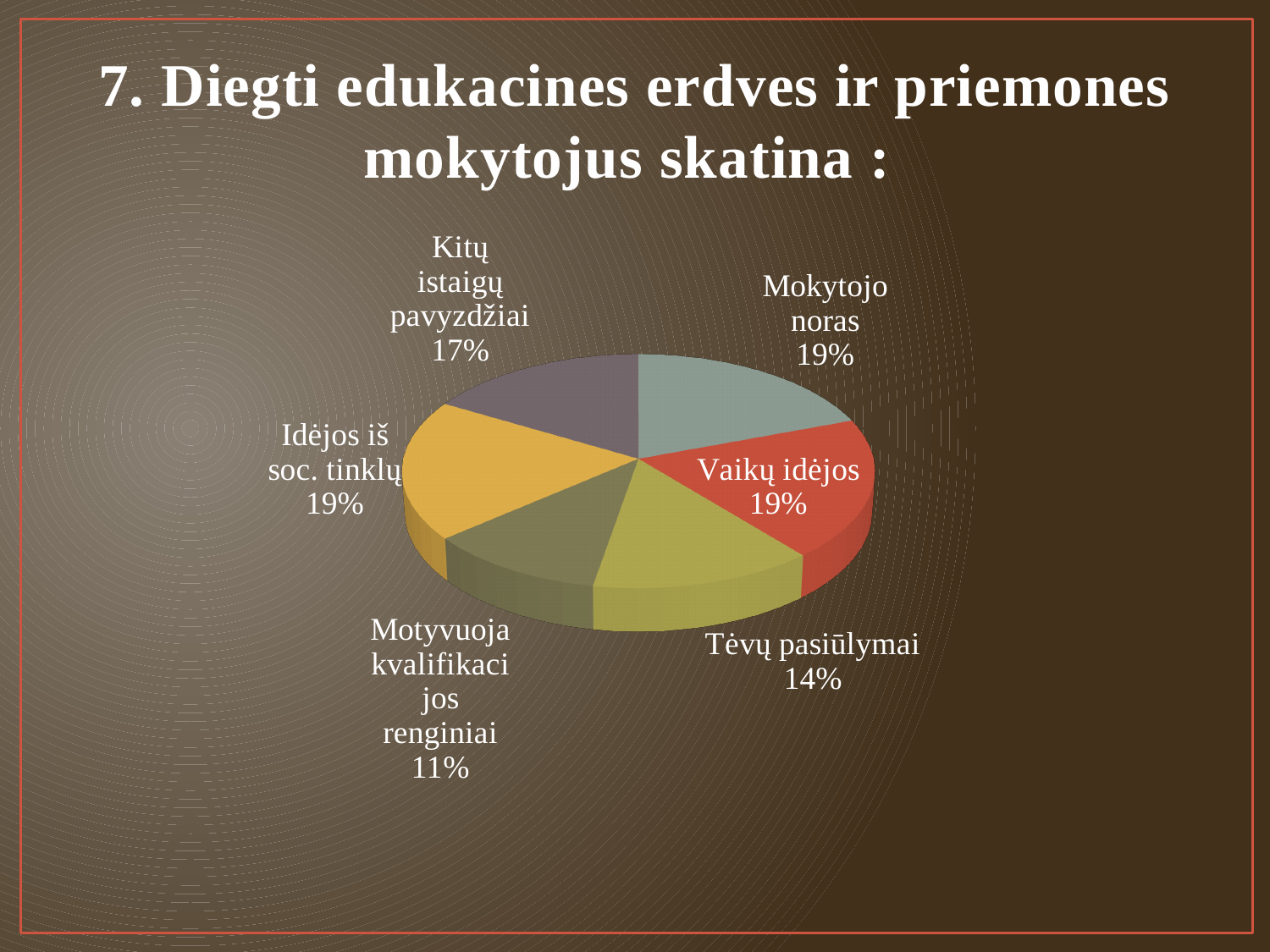
How many slices does the pie chart have? 6 Which category has the smallest slice of the pie? Motyvuoja kvalifikacijos renginiai What is the title of the slide containing the pie chart? 7. Diegti edukacines erdves ir priemones mokytojus skatina : What is the value shown for "Mokytojo noras"? 19% Which is larger, the share for "Kitų istaigų pavyzdžiai" or the share for "Tėvų pasiūlymai"? Kitų istaigų pavyzdžiai What is the difference between the shares of "Vaikų idėjos" and "Tėvų pasiūlymai"? 5% What share of the pie does "Kitų istaigų pavyzdžiai" represent? 17% What is the value shown for "Idėjos iš soc. tinklų"? 19% What share of the pie does "Tėvų pasiūlymai" represent? 14% What kind of chart is shown on the slide? pie chart What share of the pie does "Motyvuoja kvalifikacijos renginiai" represent? 11% What is the difference between the shares of "Kitų istaigų pavyzdžiai" and "Motyvuoja kvalifikacijos renginiai"? 6%